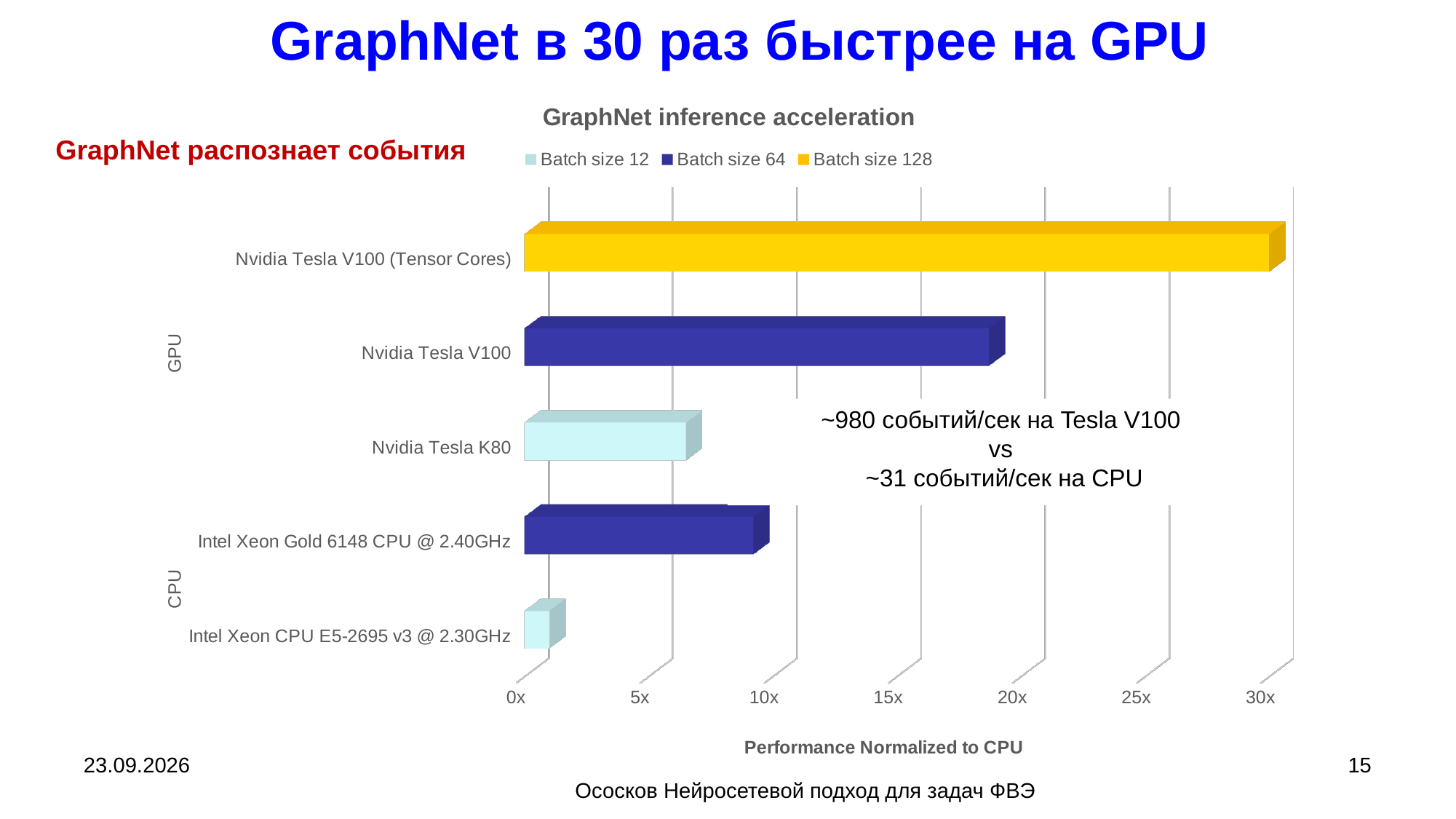
How many hardware categories are plotted in the chart? 5 Which hardware category has the highest performance value in the chart? Nvidia Tesla V100 (Tensor Cores) Is the value for Intel Xeon Gold 6148 CPU @ 2.40GHz greater or less than 10x? less What is the title of the chart? GraphNet inference acceleration What is the label of the horizontal axis of the chart? Performance Normalized to CPU Which has the larger value, Nvidia Tesla K80 or Intel Xeon Gold 6148 CPU @ 2.40GHz? Intel Xeon Gold 6148 CPU @ 2.40GHz Is the value for Nvidia Tesla V100 (Tensor Cores) greater or less than 25x? greater Is the value for Nvidia Tesla V100 greater or less than 20x? less What kind of chart is shown on the slide? bar chart Which hardware category has the lowest performance value in the chart? Intel Xeon CPU E5-2695 v3 @ 2.30GHz How many series does the chart legend list? 3